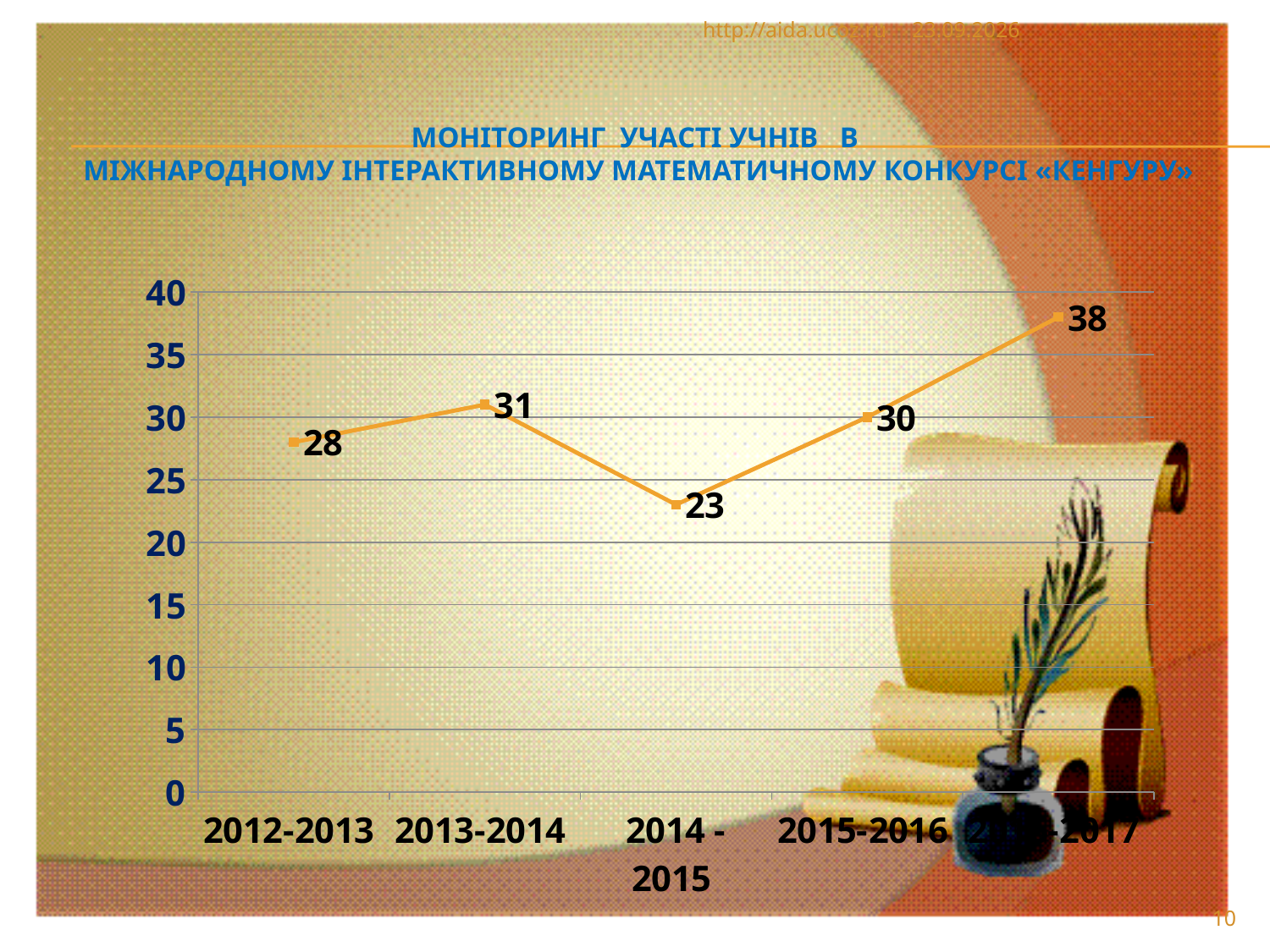
What kind of chart is shown on the slide? line chart What is the value for 2014-2015? 23 Is the value for 2014-2015 greater or less than 25? less How many data points are plotted on the chart? 5 What is the value for 2012-2013? 28 What is the value for 2013-2014? 31 What is the difference between the values for 2013-2014 and 2014-2015? 8 Does the value rise or fall from 2015-2016 to the last point? rise What is the value for 2015-2016? 30 Which period has the lowest value? 2014-2015 What is the value of the last (rightmost) point on the line? 38 Which is larger, the value for 2012-2013 or the value for 2015-2016? 2015-2016